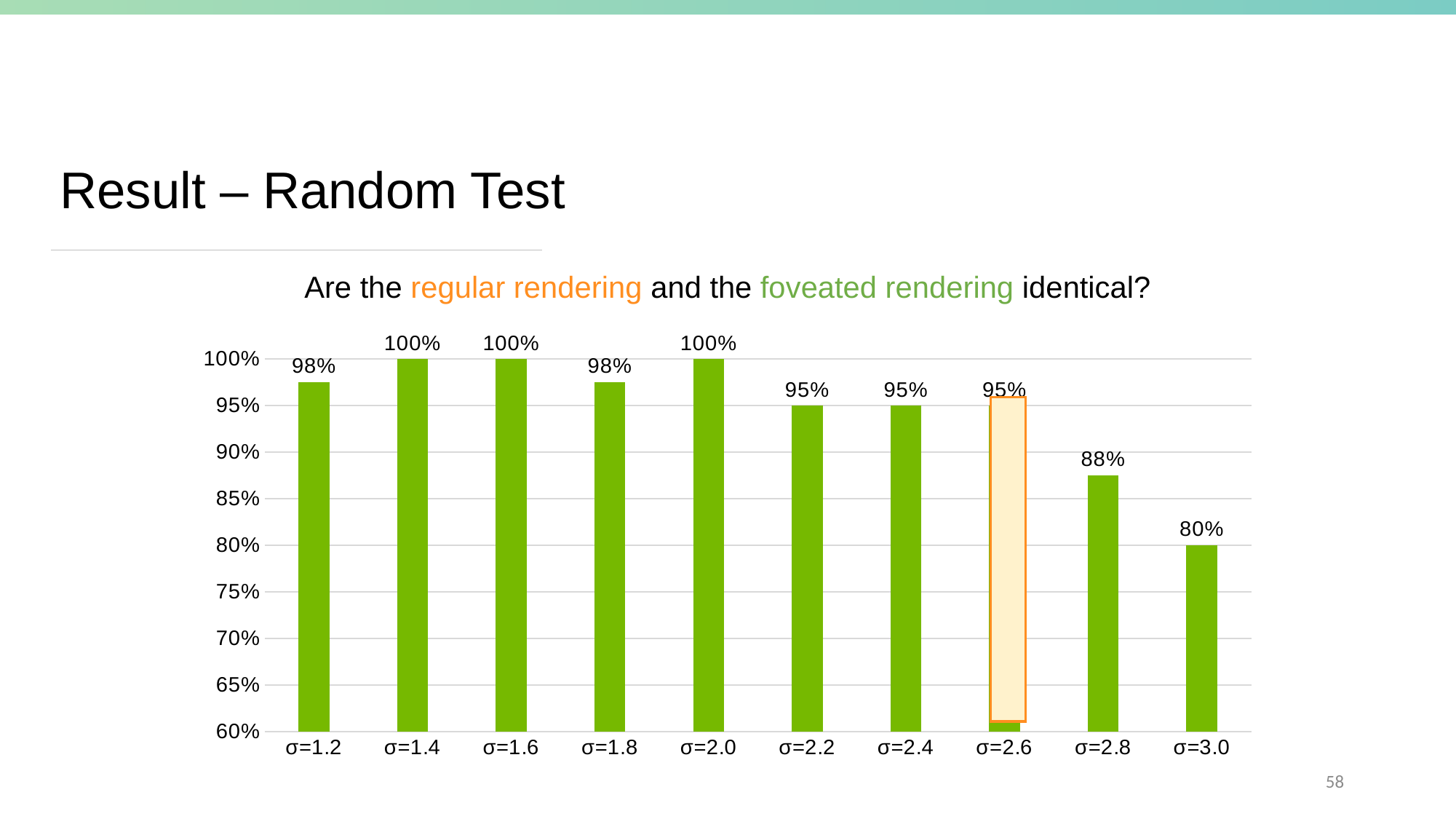
What is the difference between the values for σ=1.2 and σ=2.8? 10% Is the value for σ=2.8 greater or less than 85%? greater What is the difference between the values for σ=2.0 and σ=3.0? 20% Which category's bar is highlighted with an orange box? σ=2.6 How many categories are shown on the x axis? 10 Which is larger, the value for σ=1.8 or the value for σ=2.4? σ=1.8 What is the value for σ=3.0? 80% What kind of chart is shown on the slide? Bar chart What is the value for σ=2.2? 95% Which category has the lowest value? σ=3.0 What is the value for σ=2.8? 88% What is the value for σ=1.2? 98%